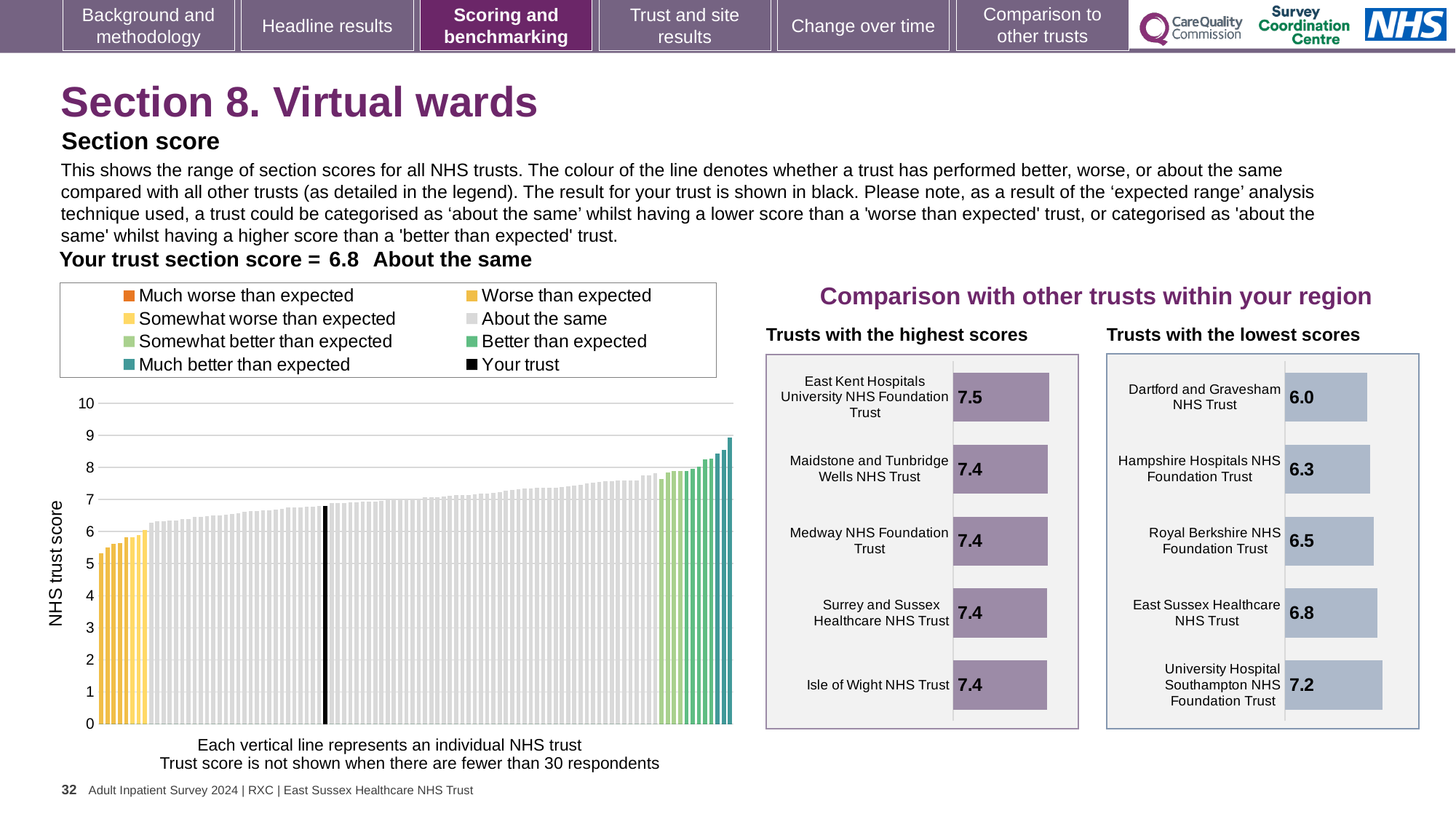
In the 'Trusts with the lowest scores' chart, what is the score for East Sussex Healthcare NHS Trust? 6.8 In the 'Trusts with the lowest scores' chart, which has the larger score: Royal Berkshire NHS Foundation Trust or Hampshire Hospitals NHS Foundation Trust? Royal Berkshire NHS Foundation Trust What kind of chart is the 'NHS trust score' chart on the left of the slide? Bar chart In the 'Trusts with the lowest scores' chart, what is the score for Hampshire Hospitals NHS Foundation Trust? 6.3 In the 'Trusts with the lowest scores' chart, what is the difference between the scores of University Hospital Southampton NHS Foundation Trust and Dartford and Gravesham NHS Trust? 1.2 How many trusts are shown in the 'Trusts with the highest scores' chart? 5 In the 'Trusts with the highest scores' chart, what is the score for East Kent Hospitals University NHS Foundation Trust? 7.5 How many entries does the legend of the 'NHS trust score' chart on the left list? 8 In the 'Trusts with the highest scores' chart, which trust has the highest score? East Kent Hospitals University NHS Foundation Trust In the 'NHS trust score' chart on the left, is the value of the tallest bar greater or less than 8? greater In the 'Trusts with the lowest scores' chart, which trust has the lowest score? Dartford and Gravesham NHS Trust In the 'NHS trust score' chart on the left, do the values rise or fall from left to right? Rise